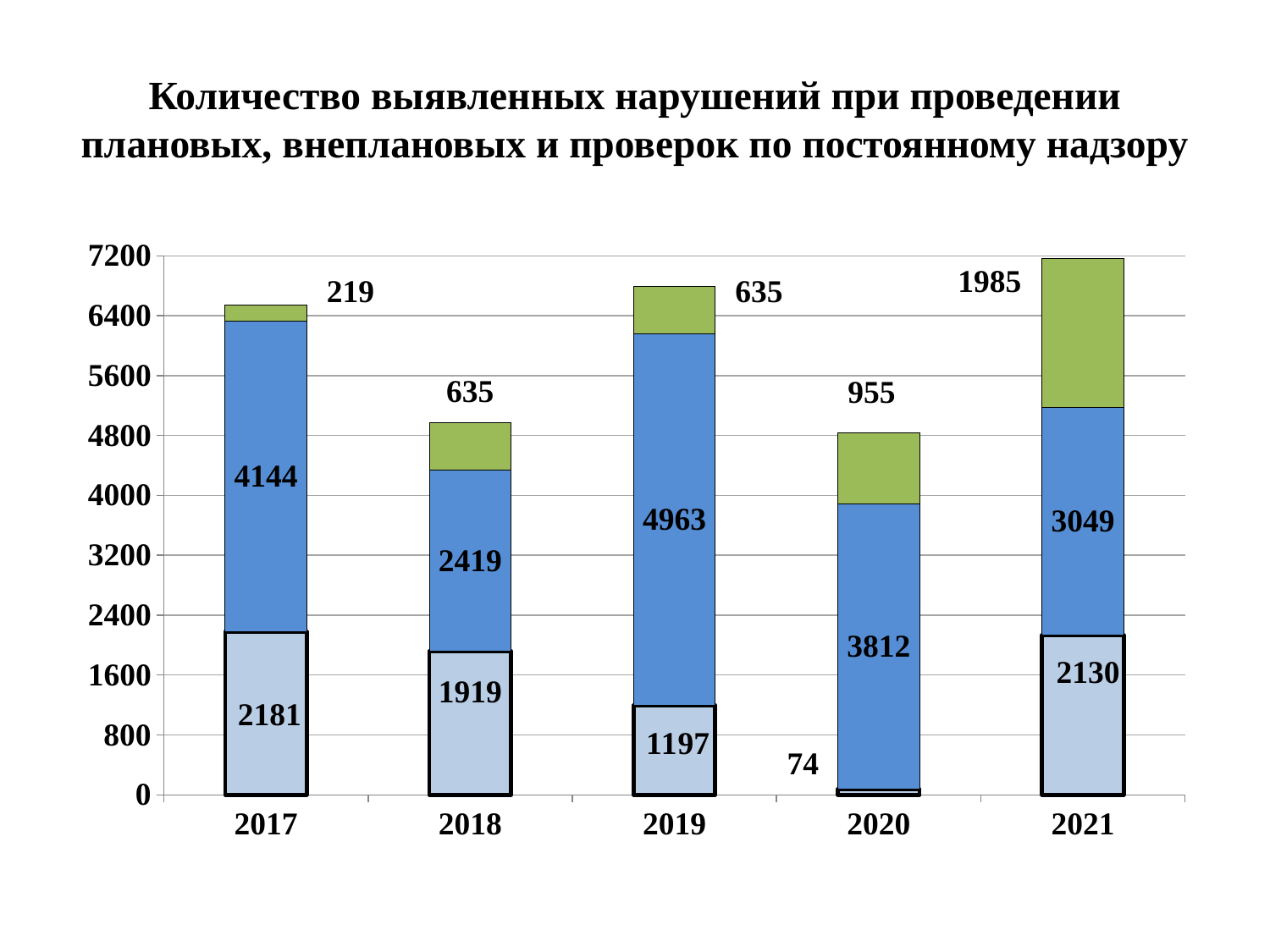
What is the value of the green (top) segment for 2021? 1985 What is the total of the stacked bar for 2018? 4973 Which year has the smallest light blue (bottom) segment? 2020 Which year has the largest blue (middle) segment? 2019 What is the value of the blue (middle) segment for 2020? 3812 What type of chart is shown on the slide? stacked bar chart What is the total of the stacked bar for 2021? 7164 What is the difference between the blue (middle) segment values for 2019 and 2018? 2544 Which is larger: the green (top) segment for 2020 or for 2019? 2020 How many years (categories) are shown on the x axis? 5 What is the value of the light blue (bottom) segment for 2017? 2181 Is the total stacked bar for 2020 greater or less than 4800? greater